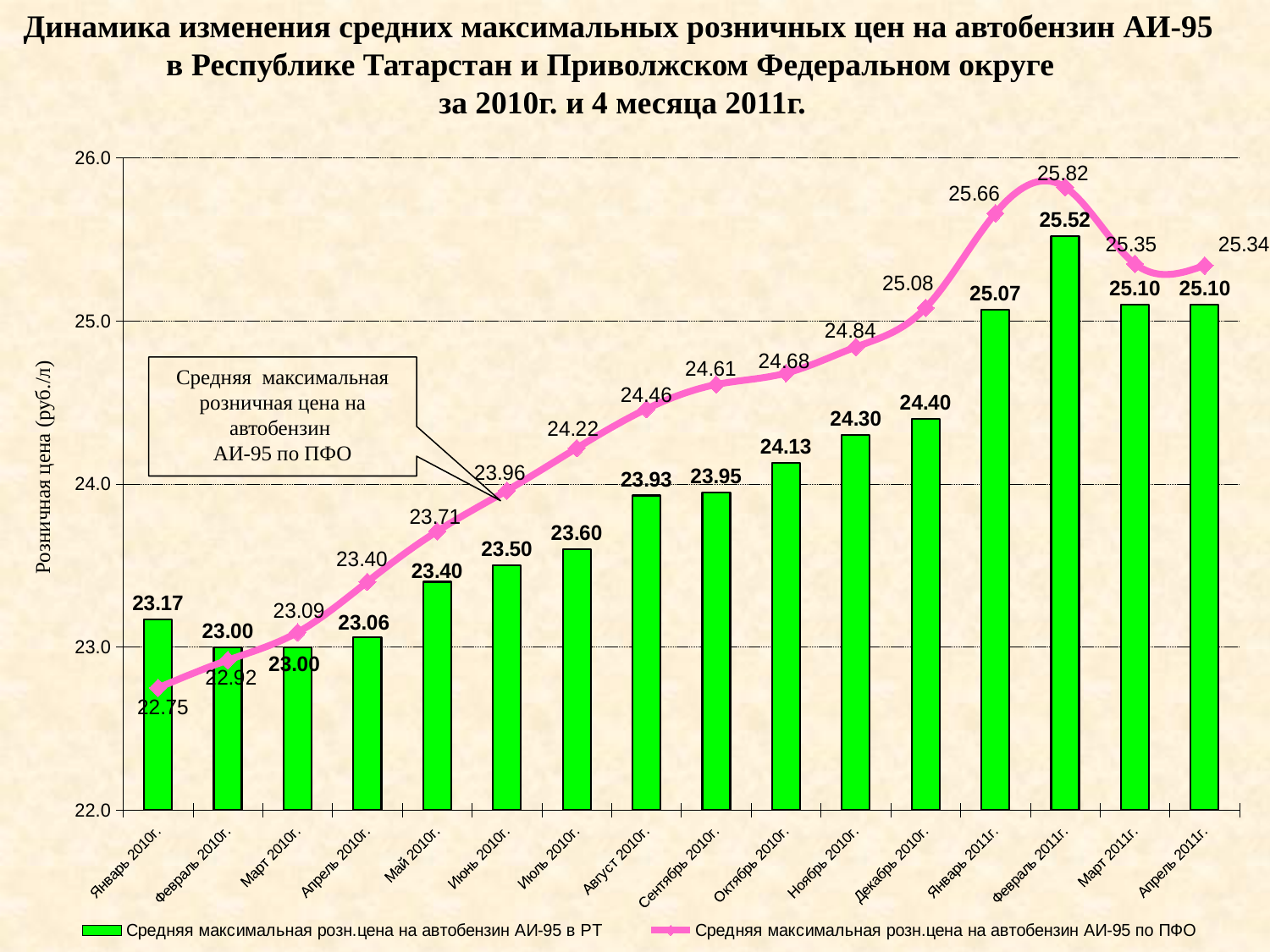
In which month does the green bar series (price in RT) reach its highest value? Февраль 2011г. For Январь 2010г., which is larger: the RT bar value or the PFO line value? RT bar value (23.17) How many months (categories) are shown on the x axis? 16 What is the average maximum retail price of AI-95 in PFO (pink line) for Декабрь 2010г.? 25.08 What kind of chart is shown on the slide? Combined bar and line chart What is the value of the green bar for Июль 2010г.? 23.60 What is the label of the y axis? Розничная цена (руб./л) What is the average maximum retail price of AI-95 in RT (green bars) for Февраль 2011г.? 25.52 How many series does the legend list? 2 What is the difference between the PFO line value and the RT bar value for Февраль 2011г.? 0.30 Does the pink line (PFO price) generally rise or fall from Январь 2010г. to Февраль 2011г.? Rise In which month is the pink line (price in PFO) at its lowest value? Январь 2010г.